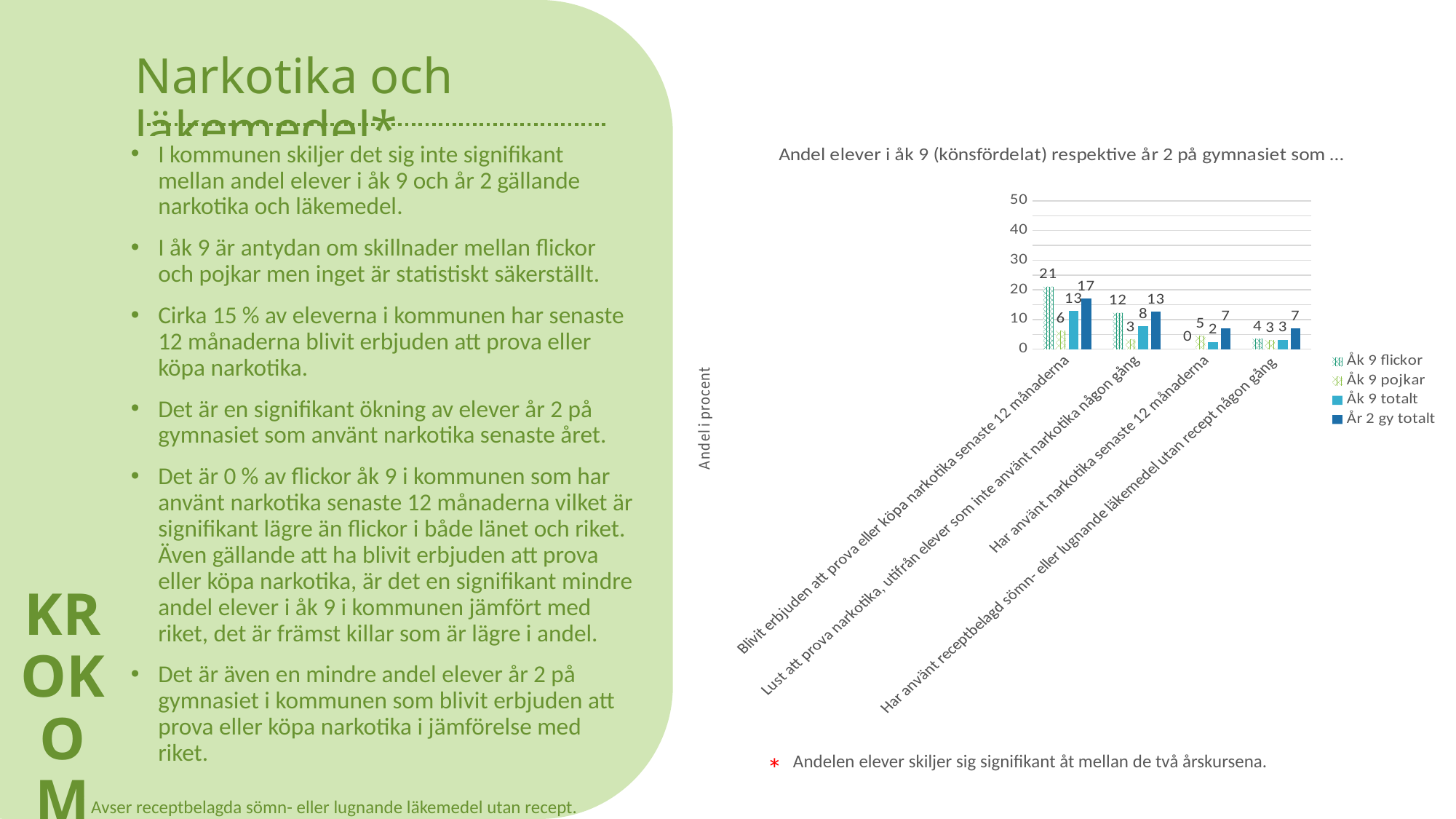
What is the value for Åk 9 pojkar in the category 'Lust att prova narkotika, utifrån elever som inte använt narkotika någon gång'? 3 Which is larger in the category 'Har använt receptbelagd sömn- eller lugnande läkemedel utan recept någon gång': Åk 9 flickor or År 2 gy totalt? År 2 gy totalt How many series does the chart legend list? 4 What is the value for Åk 9 flickor in the category 'Blivit erbjuden att prova eller köpa narkotika senaste 12 månaderna'? 21 What is the value for Åk 9 flickor in the category 'Har använt narkotika senaste 12 månaderna'? 0 What is the title of the chart? Andel elever i åk 9 (könsfördelat) respektive år 2 på gymnasiet som … Which series has the highest value in the category 'Blivit erbjuden att prova eller köpa narkotika senaste 12 månaderna'? Åk 9 flickor What kind of chart is shown on the slide? bar chart Which series has the lowest value in the category 'Lust att prova narkotika, utifrån elever som inte använt narkotika någon gång'? Åk 9 pojkar What is the difference between Åk 9 flickor and Åk 9 pojkar in the category 'Blivit erbjuden att prova eller köpa narkotika senaste 12 månaderna'? 15 How many categories are shown on the x axis of the chart? 4 What is the value for År 2 gy totalt in the category 'Har använt narkotika senaste 12 månaderna'? 7